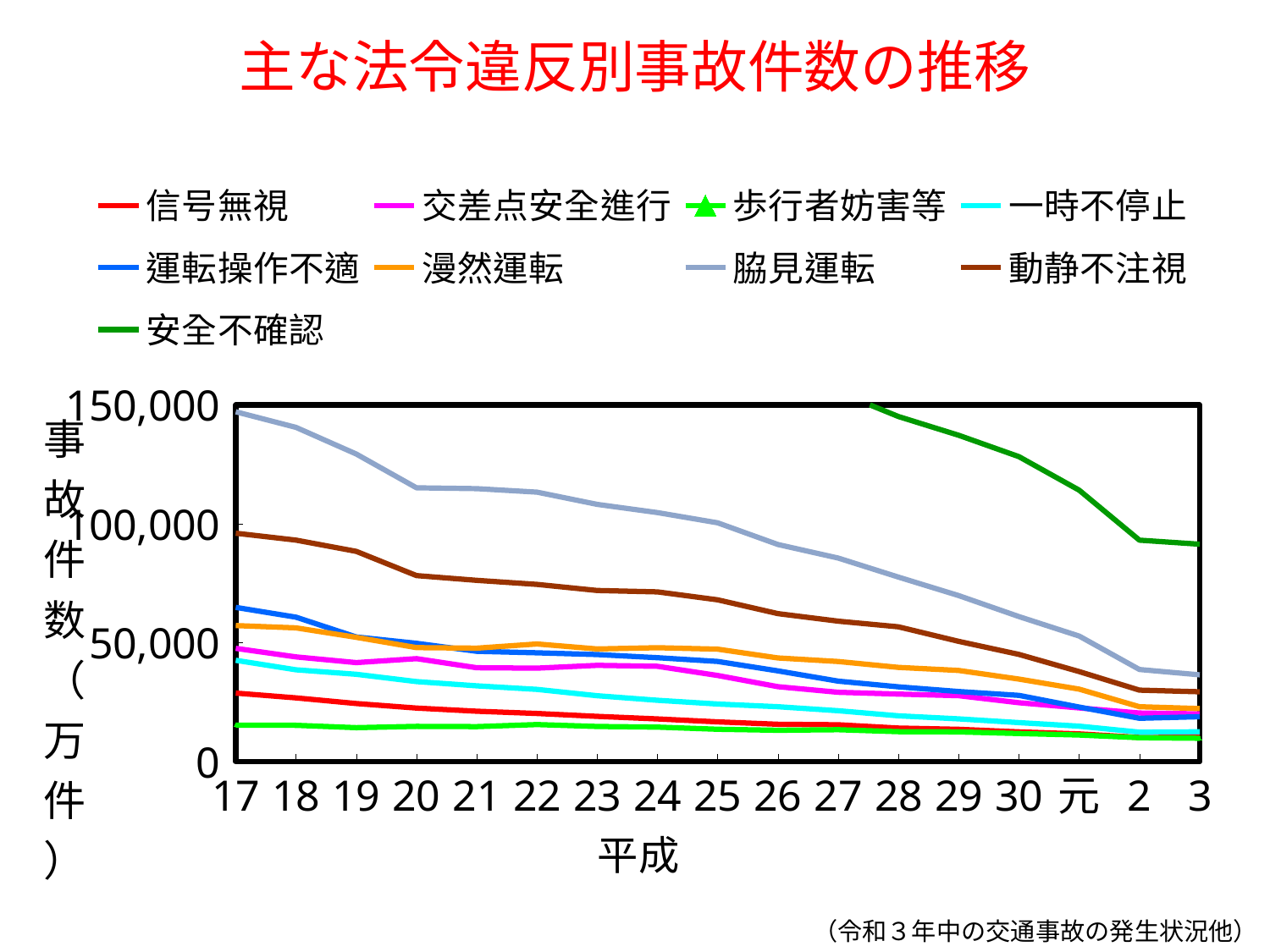
What kind of chart is shown on the slide? line chart Is the value for 安全不確認 at 平成28 greater or less than 100,000? greater Does the 脇見運転 line rise or fall from 平成17 to 3? fall Which series has the highest value at 平成17? 安全不確認 Is the value for 信号無視 at 平成17 greater or less than 50,000? less Is the value for 脇見運転 at 平成17 greater or less than 100,000? greater Which is larger at 平成17, 一時不停止 or 信号無視? 一時不停止 How many points are shown along the x axis? 17 What is the title of the chart? 主な法令違反別事故件数の推移 Which series has the lowest value at 平成17? 歩行者妨害等 Which series has the highest value at the last point (3)? 安全不確認 How many series does the legend list? 9